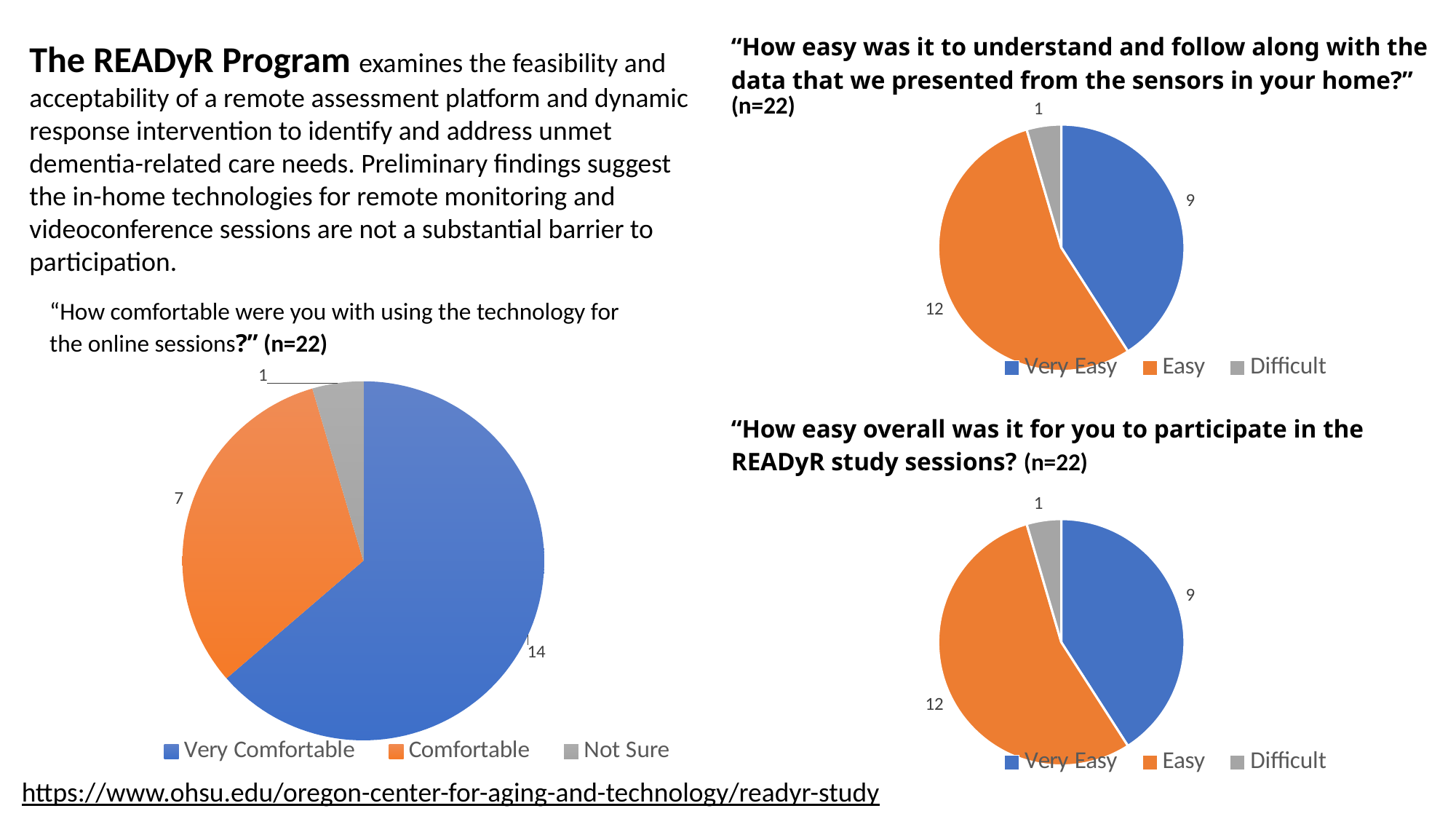
In the pie chart about how easy overall it was to participate in the READyR study sessions, is the Easy slice larger or smaller than the Very Easy slice? larger In the pie chart about how easy overall it was to participate in the READyR study sessions, how many respondents answered Very Easy? 9 In the pie chart about comfort with using the technology for the online sessions, which response category has the smallest slice? Not Sure In the pie chart about how easy it was to understand and follow along with the sensor data, which response category has the largest slice? Easy In the pie chart about how easy it was to understand and follow along with the sensor data, what colour is the Difficult slice? grey In the pie chart about how easy it was to understand and follow along with the sensor data, how many respondents answered Difficult? 1 What type of chart is used to show how easy overall it was to participate in the READyR study sessions? pie chart In the pie chart about how easy it was to understand and follow along with the sensor data, how many respondents answered Easy? 12 In the pie chart about comfort with using the technology for the online sessions, what is the difference between the Very Comfortable and Comfortable counts? 7 In the pie chart about comfort with using the technology for the online sessions, how many respondents answered Comfortable? 7 In the pie chart about how comfortable participants were with using the technology for the online sessions, how many respondents answered Very Comfortable? 14 How many response categories does the legend of the pie chart about comfort with using the technology for the online sessions list? 3